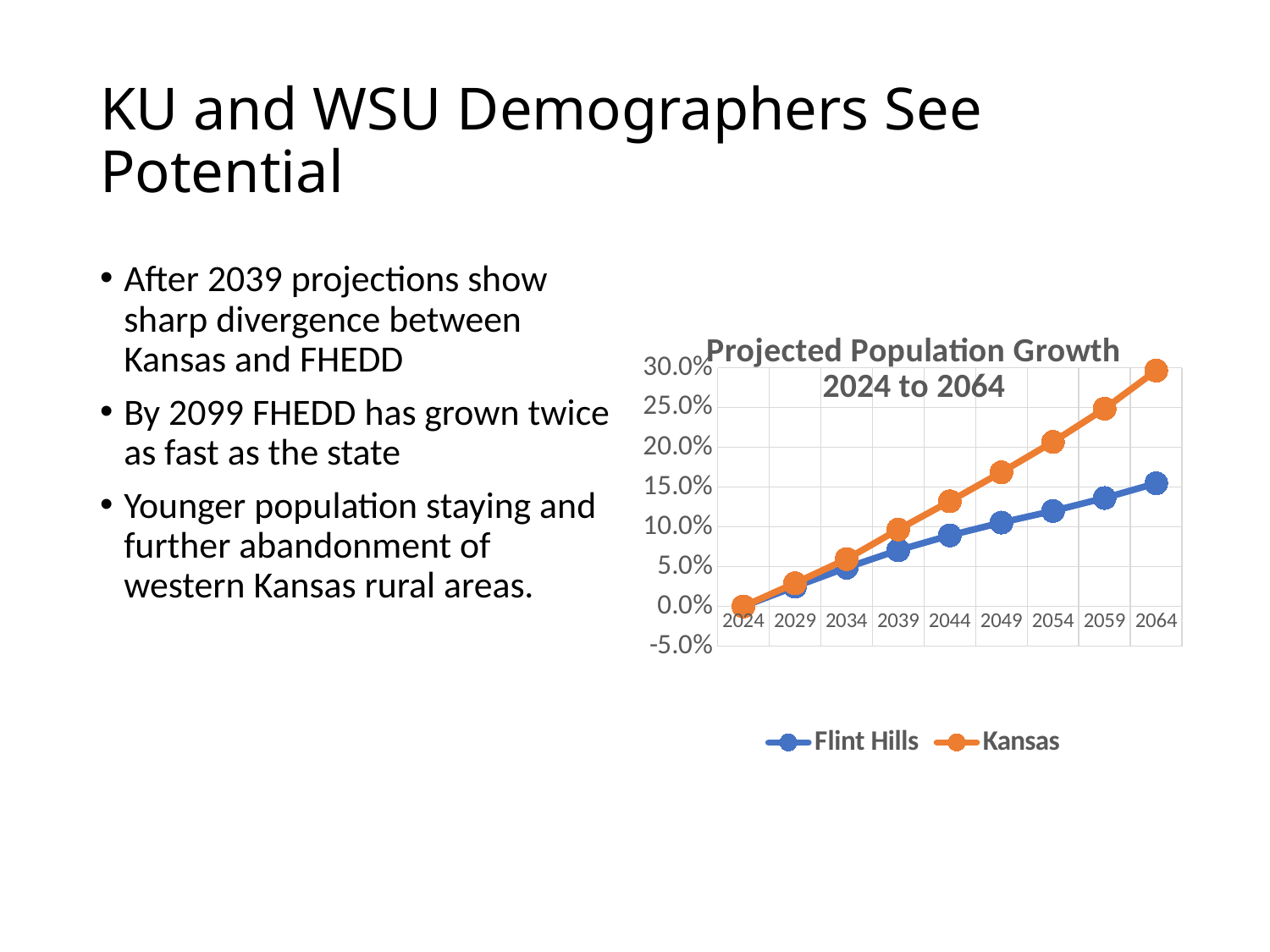
Is the value for Kansas in 2049 greater or less than 15.0%? greater In which year does the Kansas series reach its highest value? 2064 Is the value for Kansas in 2064 greater or less than 25.0%? greater Is the value for Flint Hills in 2044 greater or less than 10.0%? less In 2064, which series has the larger value, Flint Hills or Kansas? Kansas What kind of chart is shown on the slide? line chart What is the value for Kansas in 2024? 0.0% How many years are plotted along the x axis of the chart? 9 What is the title of the chart? Projected Population Growth 2024 to 2064 How many series does the chart's legend list? 2 Which colour is used for the Flint Hills series in the chart? blue Do the values for Kansas rise or fall from 2024 to 2064? rise